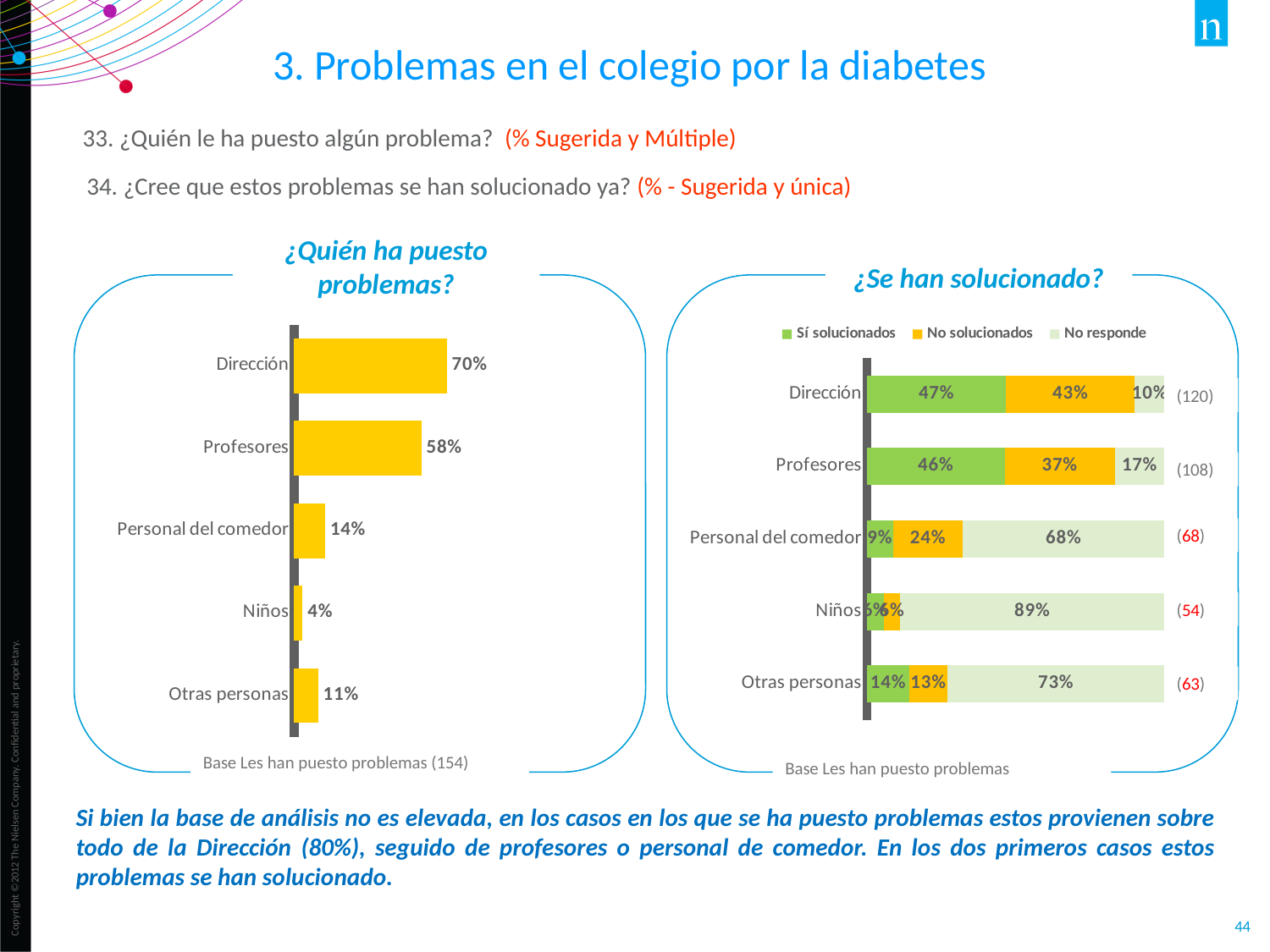
In the '¿Quién ha puesto problemas?' chart, how many categories are shown? 5 In the '¿Se han solucionado?' chart, which category has the highest 'No responde' value? Niños In the '¿Se han solucionado?' chart, what is the 'No solucionados' value for Profesores? 37% In the '¿Se han solucionado?' chart, how many series does the legend list? 3 In the '¿Se han solucionado?' chart, which category has the highest 'Sí solucionados' value? Dirección In the '¿Quién ha puesto problemas?' chart, what is the difference between Dirección and Profesores? 12 percentage points In the '¿Quién ha puesto problemas?' chart, what is the value for Personal del comedor? 14% In the '¿Quién ha puesto problemas?' chart, what is the value for Dirección? 70% In the '¿Se han solucionado?' chart, what is the 'No responde' value for Personal del comedor? 68% What kind of chart is the '¿Quién ha puesto problemas?' chart? Bar chart In the '¿Quién ha puesto problemas?' chart, which category has the lowest value? Niños In the '¿Se han solucionado?' chart, which is larger for Otras personas: 'Sí solucionados' or 'No solucionados'? Sí solucionados